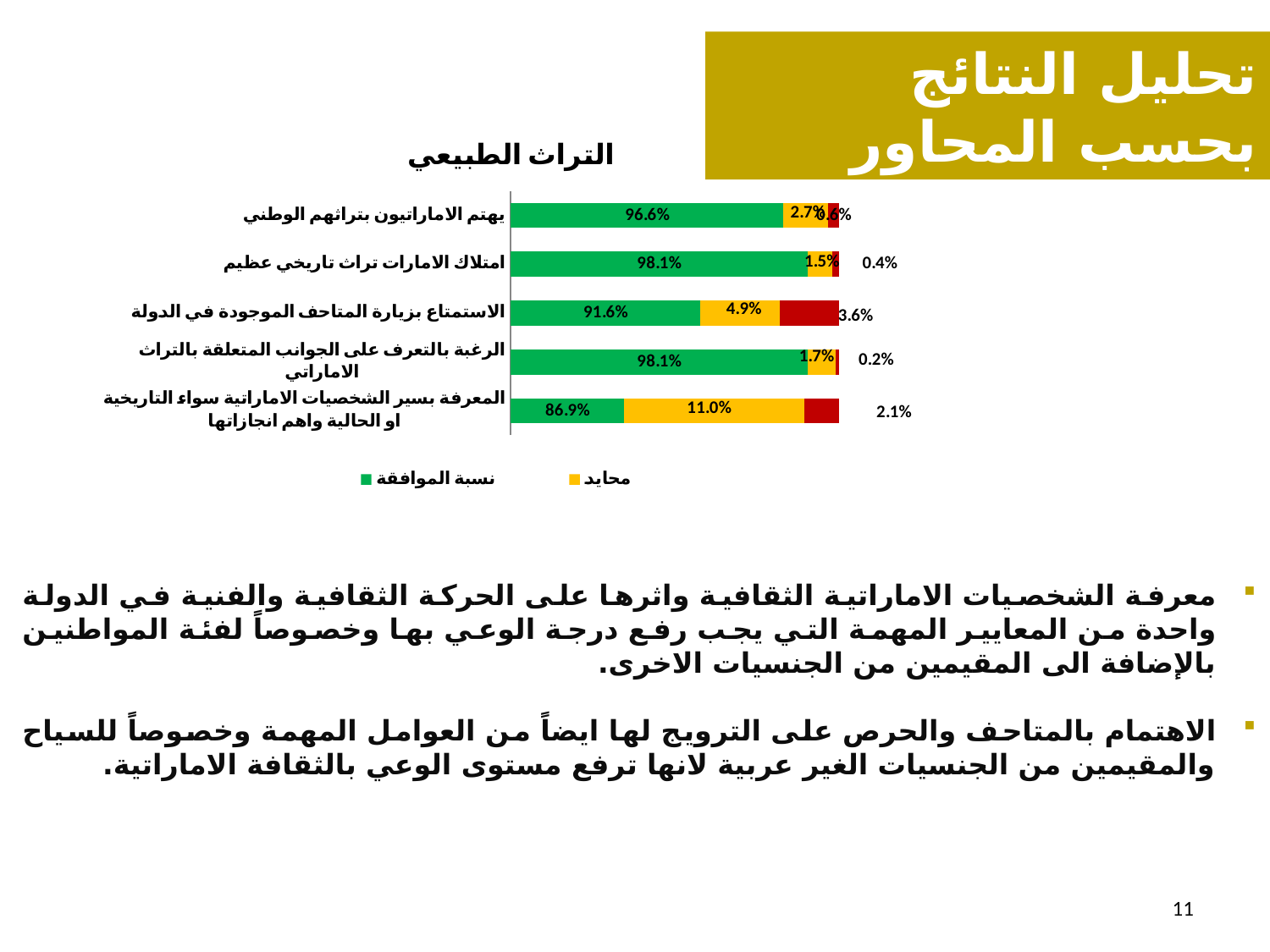
What kind of chart is shown on the slide? Stacked bar chart How many series does the legend list? 2 What is the title of the chart? التراث الطبيعي Which category has the highest neutral (محايد) percentage? المعرفة بسير الشخصيات الاماراتية سواء التاريخية او الحالية واهم انجازاتها What is the neutral (محايد) percentage for 'امتلاك الامارات تراث تاريخي عظيم'? 1.5% How many categories are shown in the chart? 5 Which category has the lowest agreement percentage (نسبة الموافقة)? المعرفة بسير الشخصيات الاماراتية سواء التاريخية او الحالية واهم انجازاتها What is the difference in agreement percentage between 'يهتم الاماراتيون بتراثهم الوطني' and 'المعرفة بسير الشخصيات الاماراتية سواء التاريخية او الحالية واهم انجازاتها'? 9.7 percentage points What is the agreement percentage for 'الاستمتاع بزيارة المتاحف الموجودة في الدولة'? 91.6% Which has a higher agreement percentage: 'الاستمتاع بزيارة المتاحف الموجودة في الدولة' or 'الرغبة بالتعرف على الجوانب المتعلقة بالتراث الاماراتي'? الرغبة بالتعرف على الجوانب المتعلقة بالتراث الاماراتي What is the agreement percentage (نسبة الموافقة) for 'يهتم الاماراتيون بتراثهم الوطني'? 96.6% What is the neutral (محايد) percentage for 'المعرفة بسير الشخصيات الاماراتية سواء التاريخية او الحالية واهم انجازاتها'? 11.0%